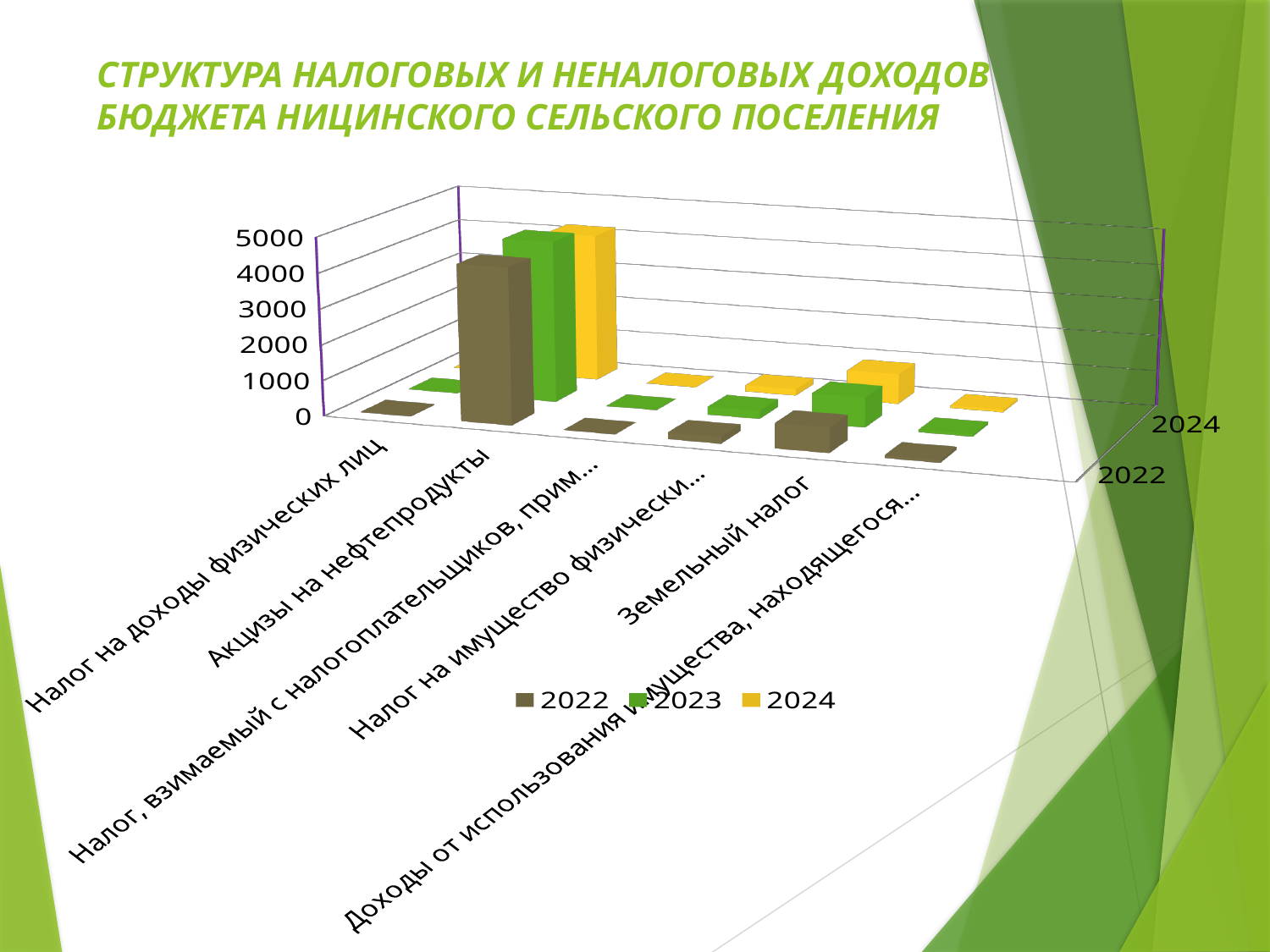
How many series does the legend list? 3 How many categories are shown on the x axis? 6 What is the title of the chart on the slide? СТРУКТУРА НАЛОГОВЫХ И НЕНАЛОГОВЫХ ДОХОДОВ БЮДЖЕТА НИЦИНСКОГО СЕЛЬСКОГО ПОСЕЛЕНИЯ What kind of chart is shown on the slide? bar chart Is the 2022 value for Акцизы на нефтепродукты greater or less than 2000? greater Which category has the highest value for 2022? Акцизы на нефтепродукты Which category has the highest value for 2024? Акцизы на нефтепродукты Which category has the highest value for 2023? Акцизы на нефтепродукты For 2023, which is larger: Акцизы на нефтепродукты or Земельный налог? Акцизы на нефтепродукты Is the 2022 value for Налог на доходы физических лиц greater or less than 1000? less Is the 2023 value for Акцизы на нефтепродукты greater or less than 3000? greater Which years are listed in the legend? 2022, 2023, 2024